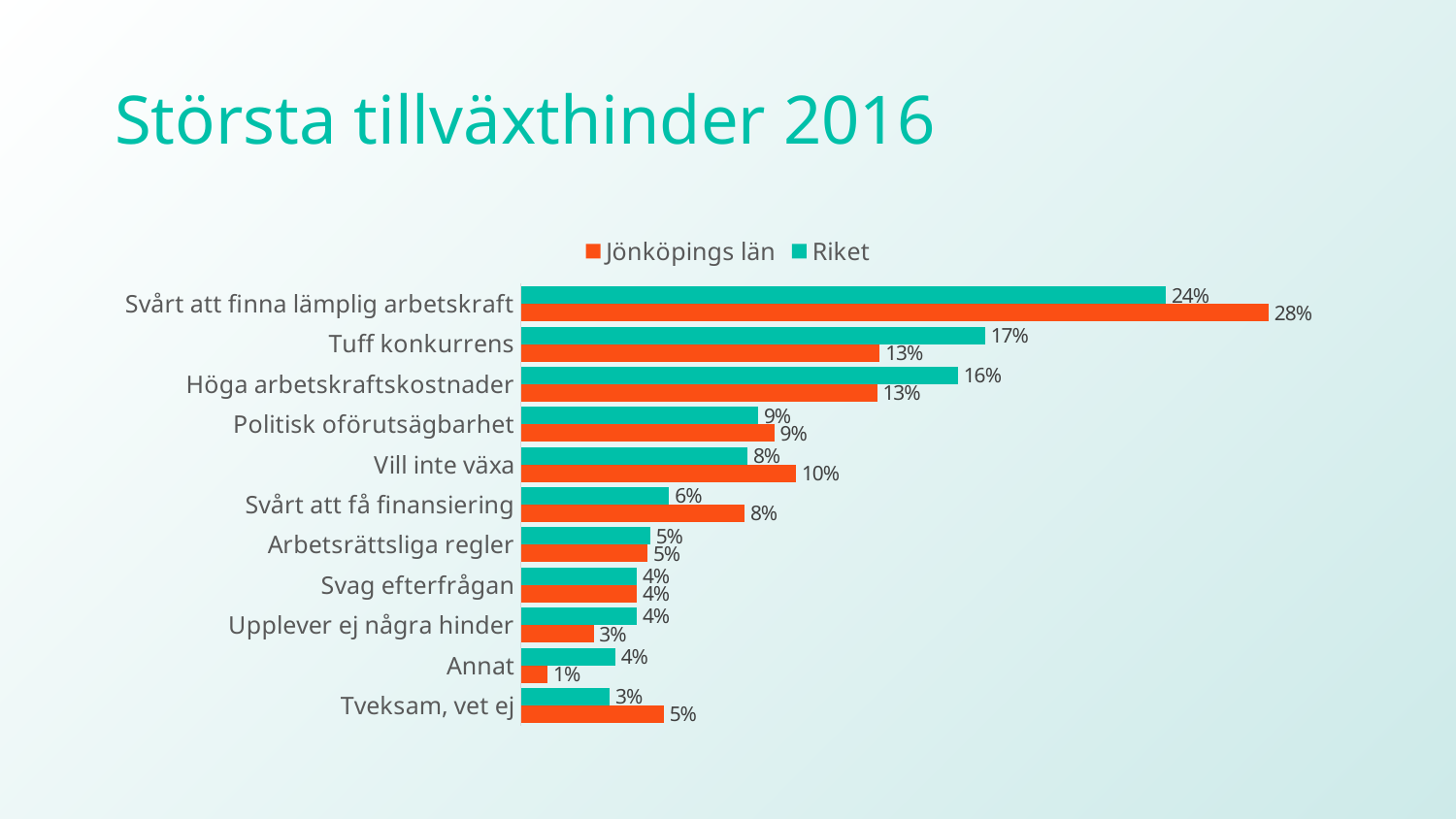
What is the value for Jönköpings län for 'Vill inte växa'? 10% What is the value for Jönköpings län for 'Svårt att finna lämplig arbetskraft'? 28% What is the value for Riket for 'Annat'? 4% Which category has the highest value for Jönköpings län? Svårt att finna lämplig arbetskraft What is the value for Riket for 'Tuff konkurrens'? 17% Which category has the lowest value for Jönköpings län? Annat How many series does the legend list? 2 What is the difference between the Riket and Jönköpings län values for 'Tuff konkurrens'? 4% What kind of chart is shown on the slide? Bar chart What is the title of the slide? Största tillväxthinder 2016 How many categories are shown in the chart? 11 Which is larger for 'Svårt att få finansiering': Jönköpings län or Riket? Jönköpings län